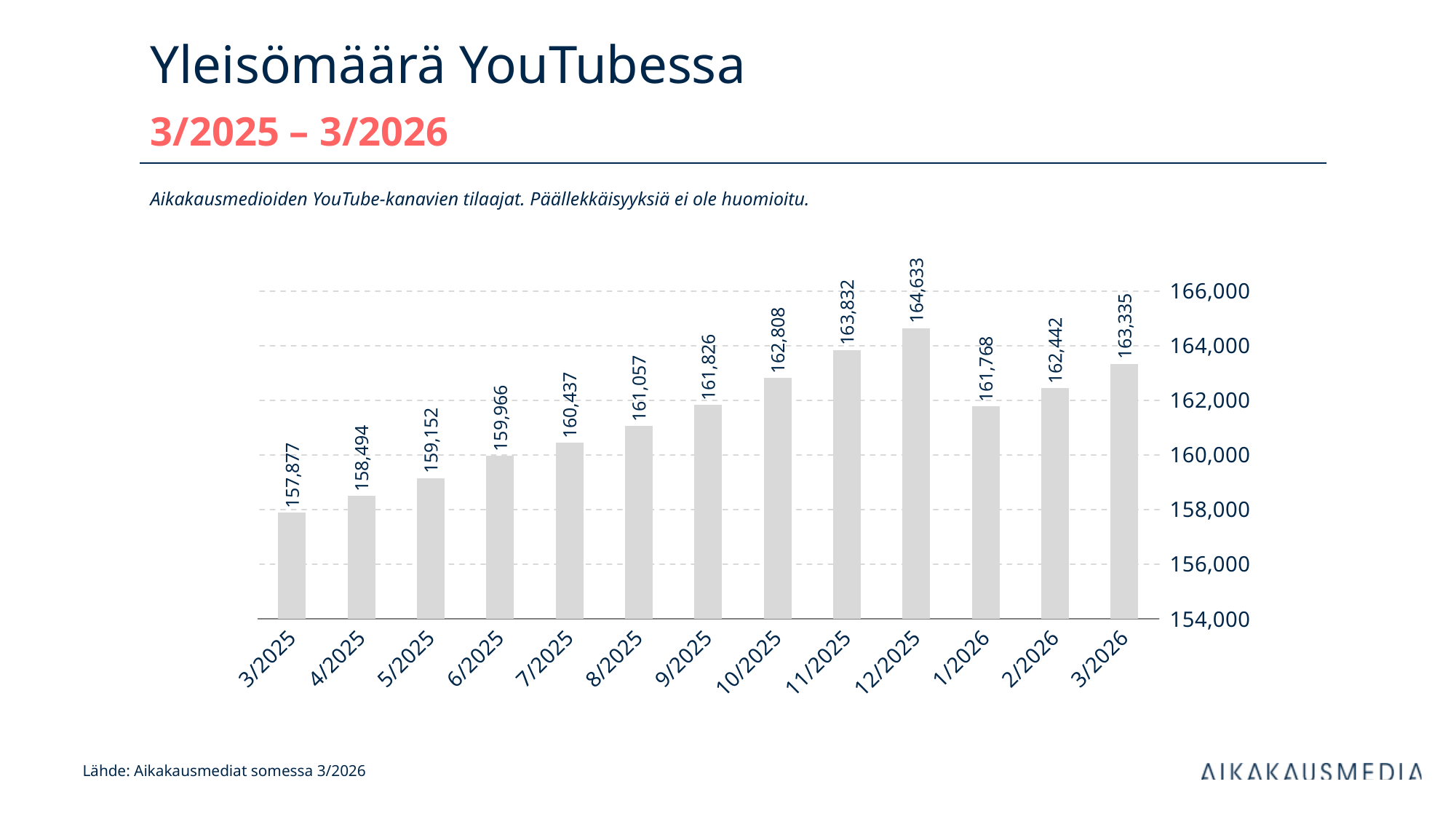
How many months are shown on the x axis? 13 What kind of chart is shown on the slide? bar chart What is the title of the slide? Yleisömäärä YouTubessa Which month has the highest value? 12/2025 What is the difference between the values for 12/2025 and 3/2025? 6,756 What is the value for 1/2026? 161,768 Is the value for 9/2025 greater or less than 162,000? less What is the value for 3/2025? 157,877 Which month has the lowest value? 3/2025 What is the value for 12/2025? 164,633 What is the difference between the values for 3/2026 and 3/2025? 5,458 Which is larger, the value for 11/2025 or the value for 3/2026? 11/2025